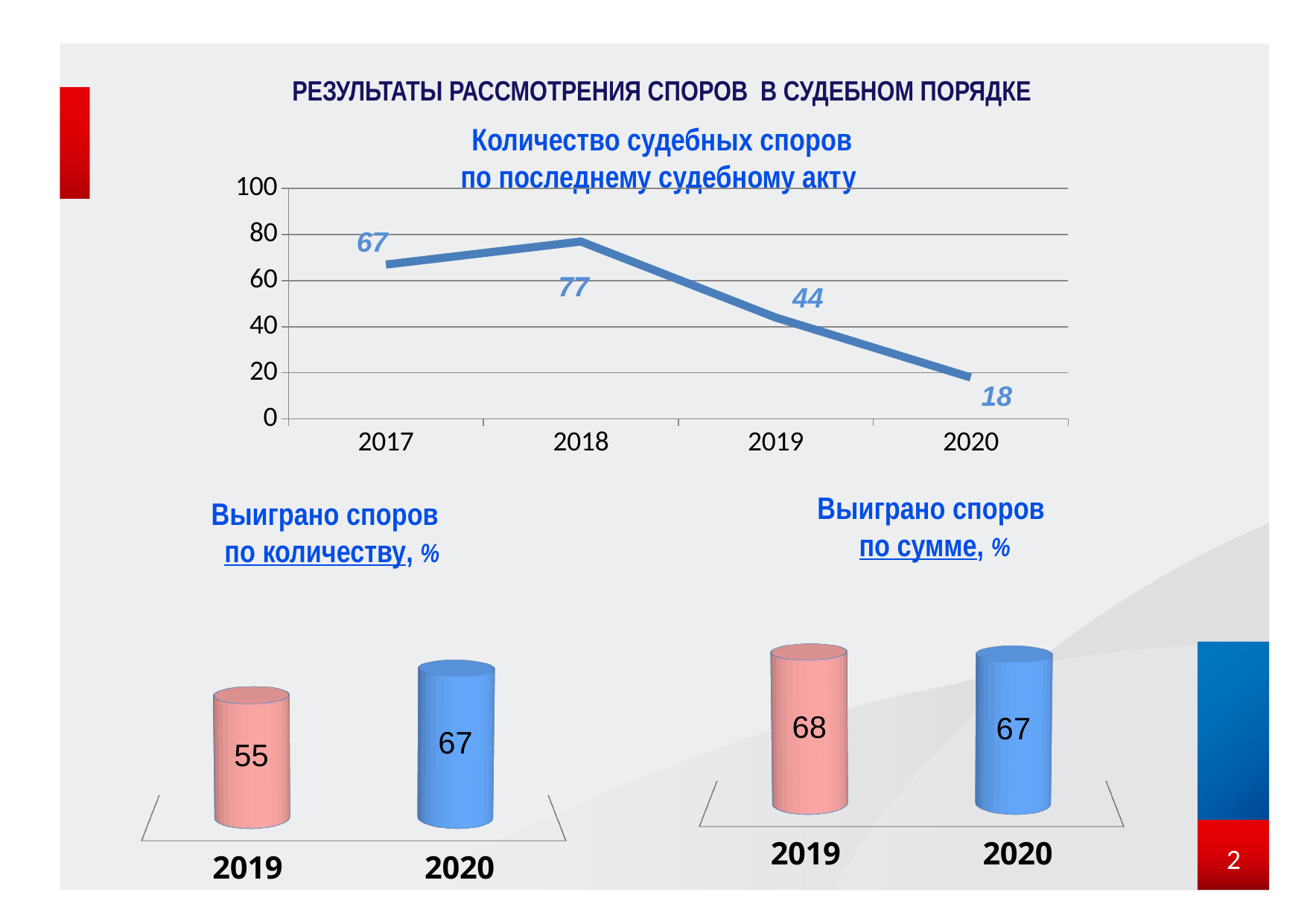
In the line chart 'Количество судебных споров по последнему судебному акту', what is the value for 2018? 77 In the line chart 'Количество судебных споров по последнему судебному акту', how many years are plotted? 4 In the chart 'Выиграно споров по количеству, %', what is the value for 2019? 55 In the chart 'Выиграно споров по количеству, %', what is the difference between 2020 and 2019? 12 What kind of chart is 'Выиграно споров по сумме, %'? bar chart In the line chart 'Количество судебных споров по последнему судебному акту', which year has the highest value? 2018 In the chart 'Выиграно споров по сумме, %', what is the value for 2020? 67 In the line chart 'Количество судебных споров по последнему судебному акту', do the values rise or fall from 2018 to 2020? fall In the line chart 'Количество судебных споров по последнему судебному акту', which year has the lowest value? 2020 What kind of chart is 'Количество судебных споров по последнему судебному акту'? line chart In the line chart 'Количество судебных споров по последнему судебному акту', what is the difference between the values for 2018 and 2019? 33 In the line chart 'Количество судебных споров по последнему судебному акту', what is the value for 2020? 18